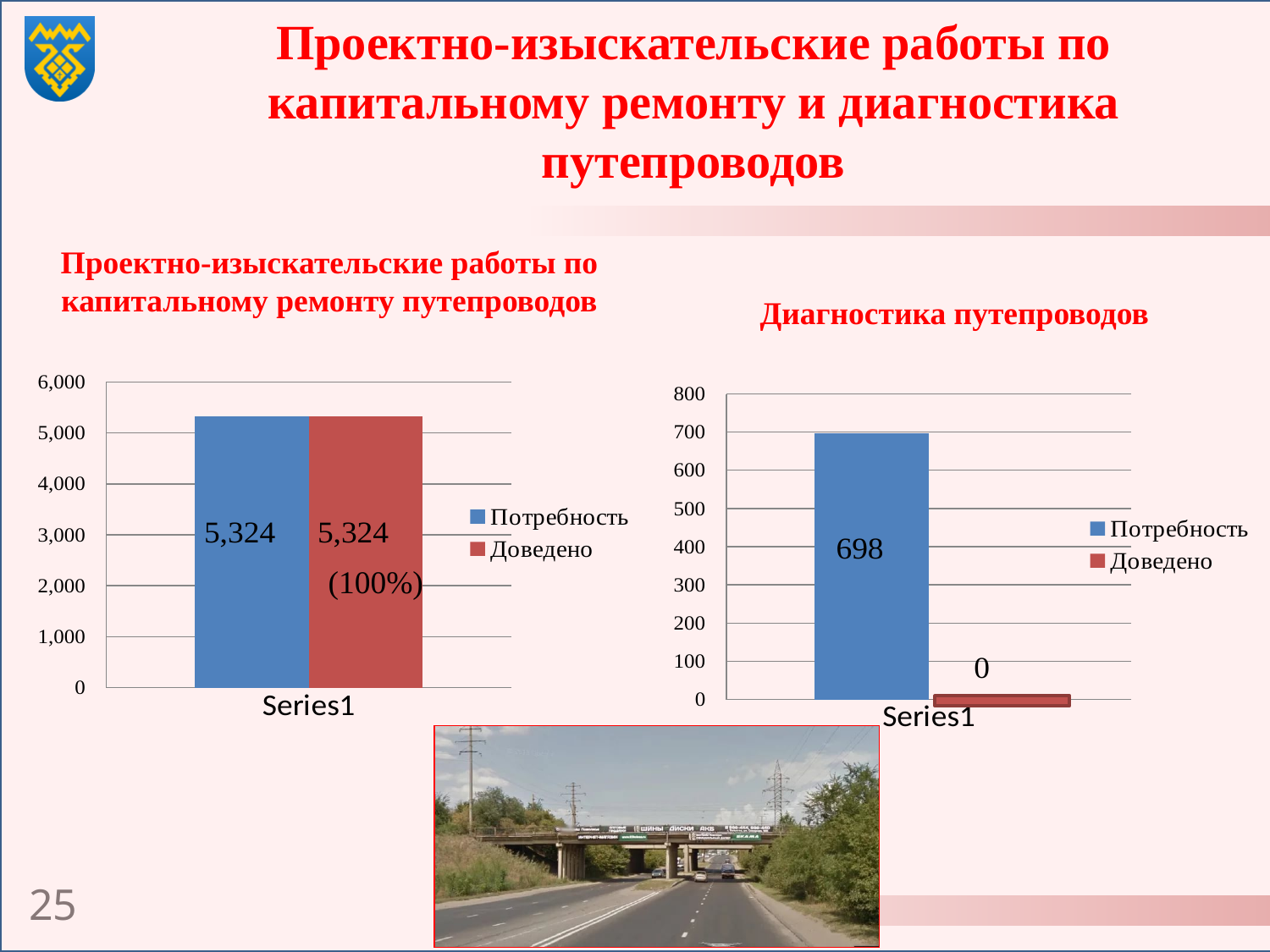
What kind of chart is the left chart (Проектно-изыскательские работы по капитальному ремонту путепроводов)? Bar chart In the right chart (Диагностика путепроводов), which series is larger, Потребность or Доведено? Потребность How many series does the legend of the right chart (Диагностика путепроводов) list? 2 In the right chart (Диагностика путепроводов), is the value for Потребность greater or less than 600? greater In the right chart (Диагностика путепроводов), what is the value for Потребность? 698 In the left chart (Проектно-изыскательские работы по капитальному ремонту путепроводов), is the value for Потребность greater or less than 5,000? greater In the right chart (Диагностика путепроводов), what is the value for Доведено? 0 In the left chart (Проектно-изыскательские работы по капитальному ремонту путепроводов), what is the difference between Потребность and Доведено? 0 In the left chart (Проектно-изыскательские работы по капитальному ремонту путепроводов), what is the value for Доведено? 5,324 In the left chart (Проектно-изыскательские работы по капитальному ремонту путепроводов), what percentage is shown next to the Доведено value? 100% In the right chart (Диагностика путепроводов), what is the difference between Потребность and Доведено? 698 In the left chart (Проектно-изыскательские работы по капитальному ремонту путепроводов), what is the value for Потребность? 5,324